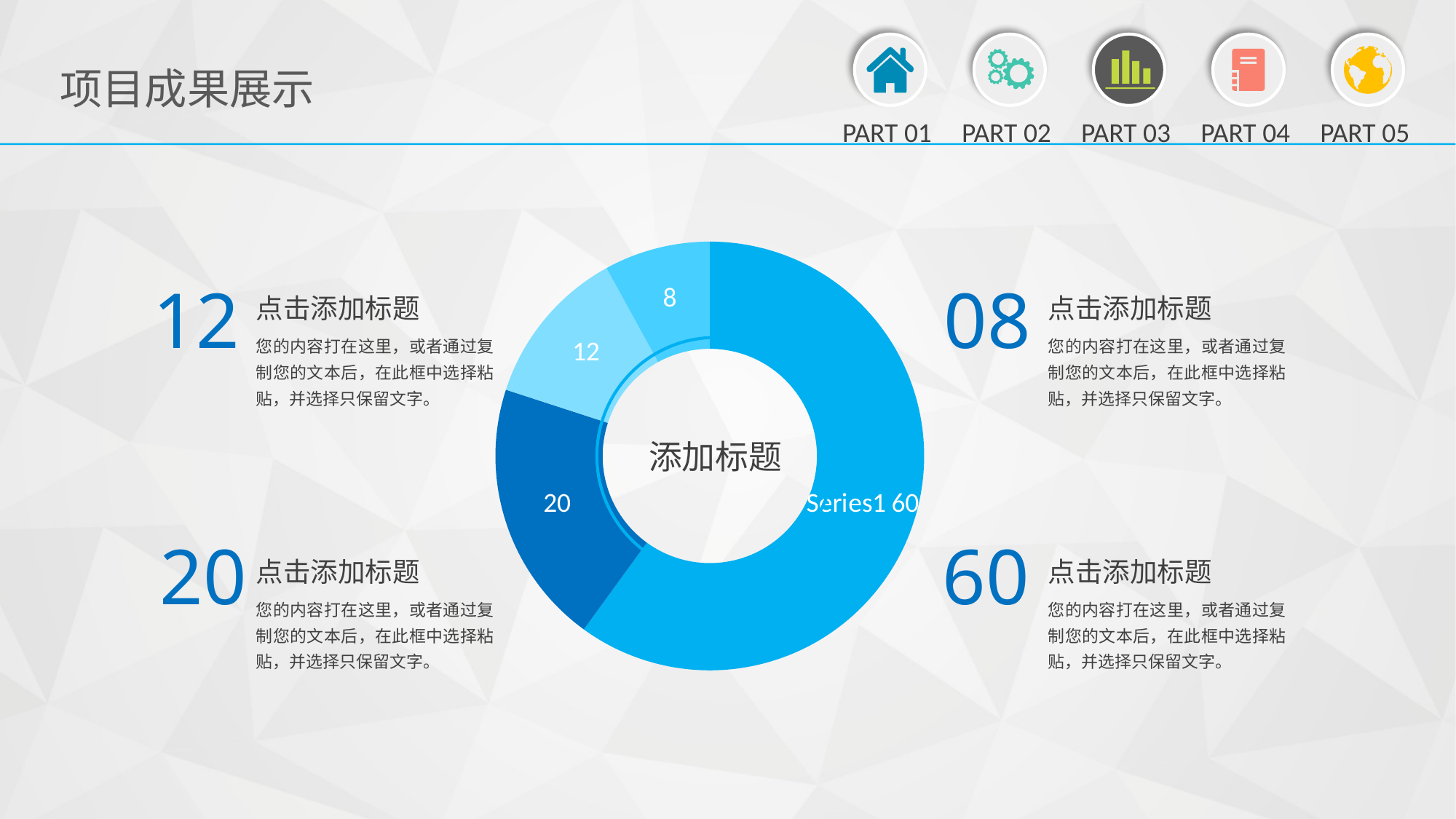
What is the difference between the largest slice (60) and the slice valued 20? 40 What is the value of the smallest slice of the doughnut chart? 8 What text is shown in the centre of the doughnut chart? 添加标题 What is the total of all the slice values in the doughnut chart? 100 What is the value of the slice labelled Series1 in the doughnut chart? 60 What kind of chart is shown on the slide? Doughnut (pie) chart What is the value of the dark blue slice on the left of the doughnut chart? 20 What share of the doughnut chart does the slice valued 60 represent? 60% Which is larger in the doughnut chart, the slice valued 12 or the slice valued 20? 20 What share of the doughnut chart does the slice valued 8 represent? 8% What is the value of the largest slice of the doughnut chart? 60 How many slices does the doughnut chart have? 4